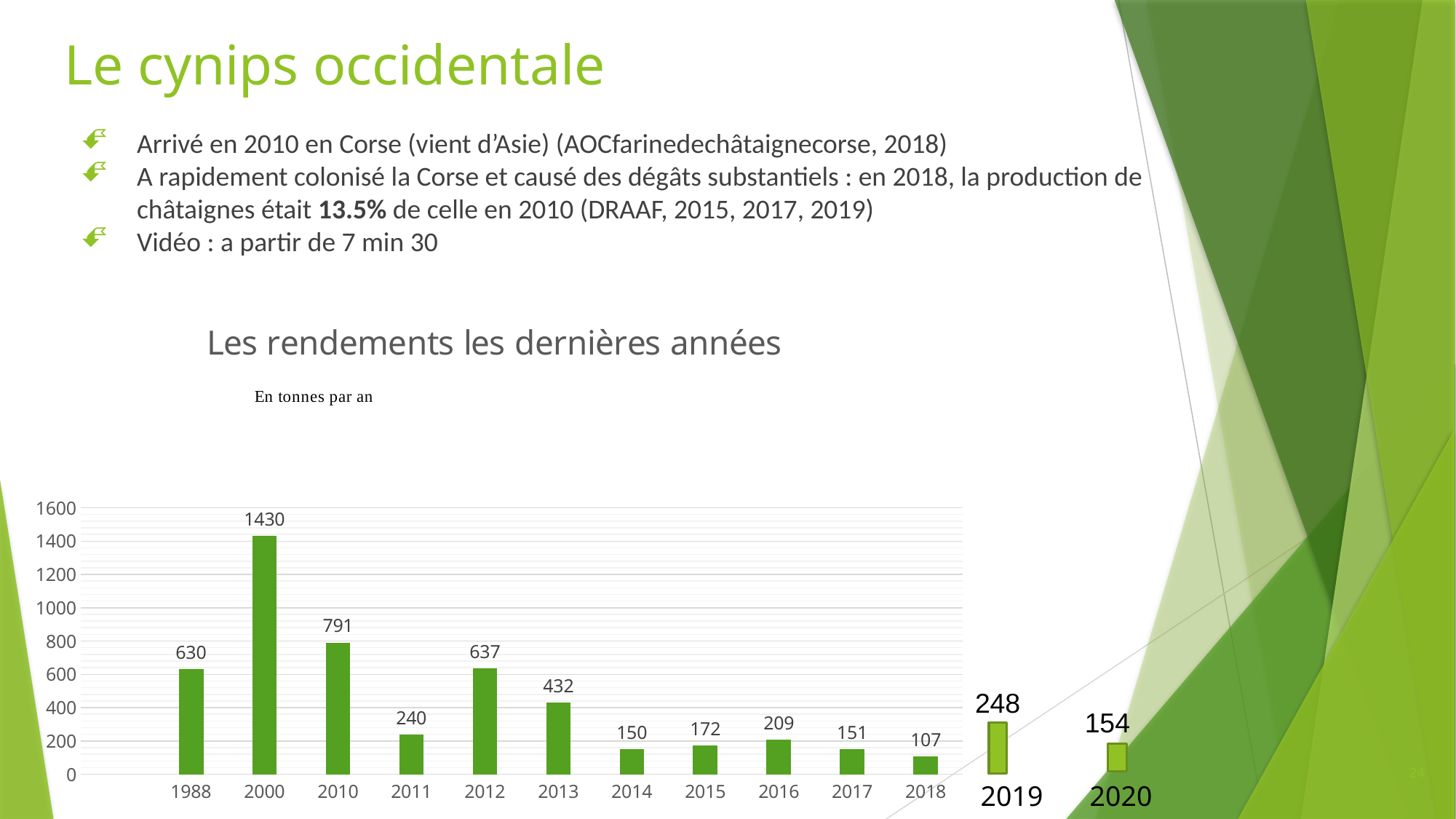
What is the value for 2018 in the chart 'Les rendements les dernières années'? 107 Which year has the lowest value in the chart 'Les rendements les dernières années'? 2018 What is the value for 2010 in the chart 'Les rendements les dernières années'? 791 What kind of chart is 'Les rendements les dernières années'? bar chart Which year has the highest value in the chart 'Les rendements les dernières années'? 2000 What is the difference between the values for 2010 and 2011 in the chart 'Les rendements les dernières années'? 551 What unit is stated below the title of the chart 'Les rendements les dernières années'? En tonnes par an In the chart 'Les rendements les dernières années', which is larger, the value for 1988 or the value for 2012? 2012 What is the value for 2013 in the chart 'Les rendements les dernières années'? 432 In the chart 'Les rendements les dernières années', do the values generally rise or fall from 2012 to 2018? fall What is the difference between the values for 2016 and 2017 in the chart 'Les rendements les dernières années'? 58 What is the value for 2000 in the chart 'Les rendements les dernières années'? 1430